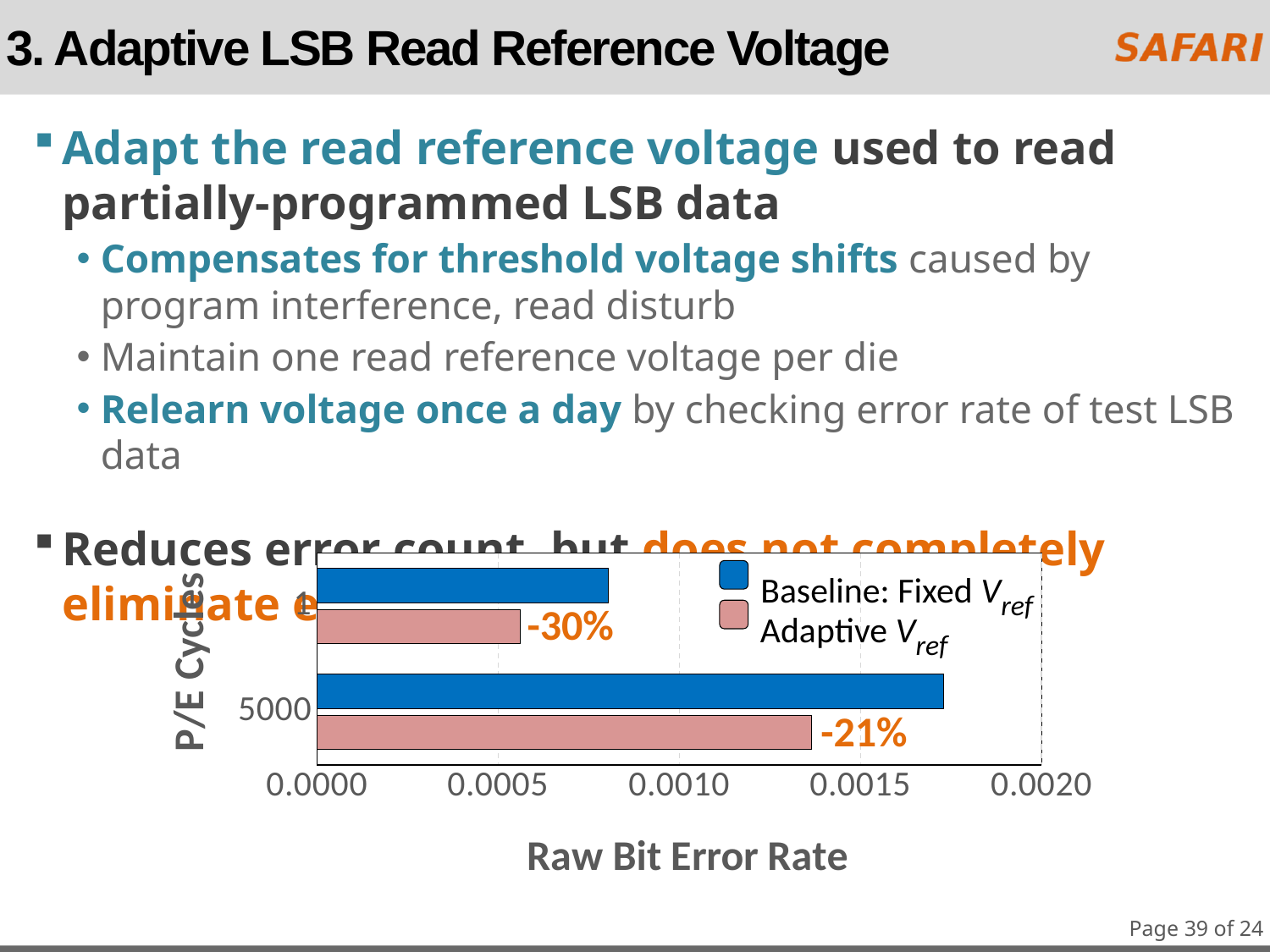
What kind of chart is shown on the slide? bar chart Is the Raw Bit Error Rate for Baseline: Fixed Vref at 5000 P/E cycles greater or less than 0.0015? greater At 5000 P/E cycles, which series has the larger Raw Bit Error Rate, Baseline: Fixed Vref or Adaptive Vref? Baseline: Fixed Vref What percentage label is printed next to the Adaptive Vref bar in the upper group of bars? -30% How many P/E cycle categories (groups of bars) are plotted in the chart? 2 Which series has the highest Raw Bit Error Rate anywhere in the chart? Baseline: Fixed Vref Is the Raw Bit Error Rate for Adaptive Vref at 5000 P/E cycles greater or less than 0.0010? greater What percentage label is printed next to the Adaptive Vref bar at 5000 P/E cycles? -21% How many series does the chart's legend list? 2 Is the Raw Bit Error Rate for Adaptive Vref at 5000 P/E cycles greater or less than 0.0015? less What is the title of the chart's x axis? Raw Bit Error Rate What are the two series named in the chart's legend? Baseline: Fixed Vref and Adaptive Vref